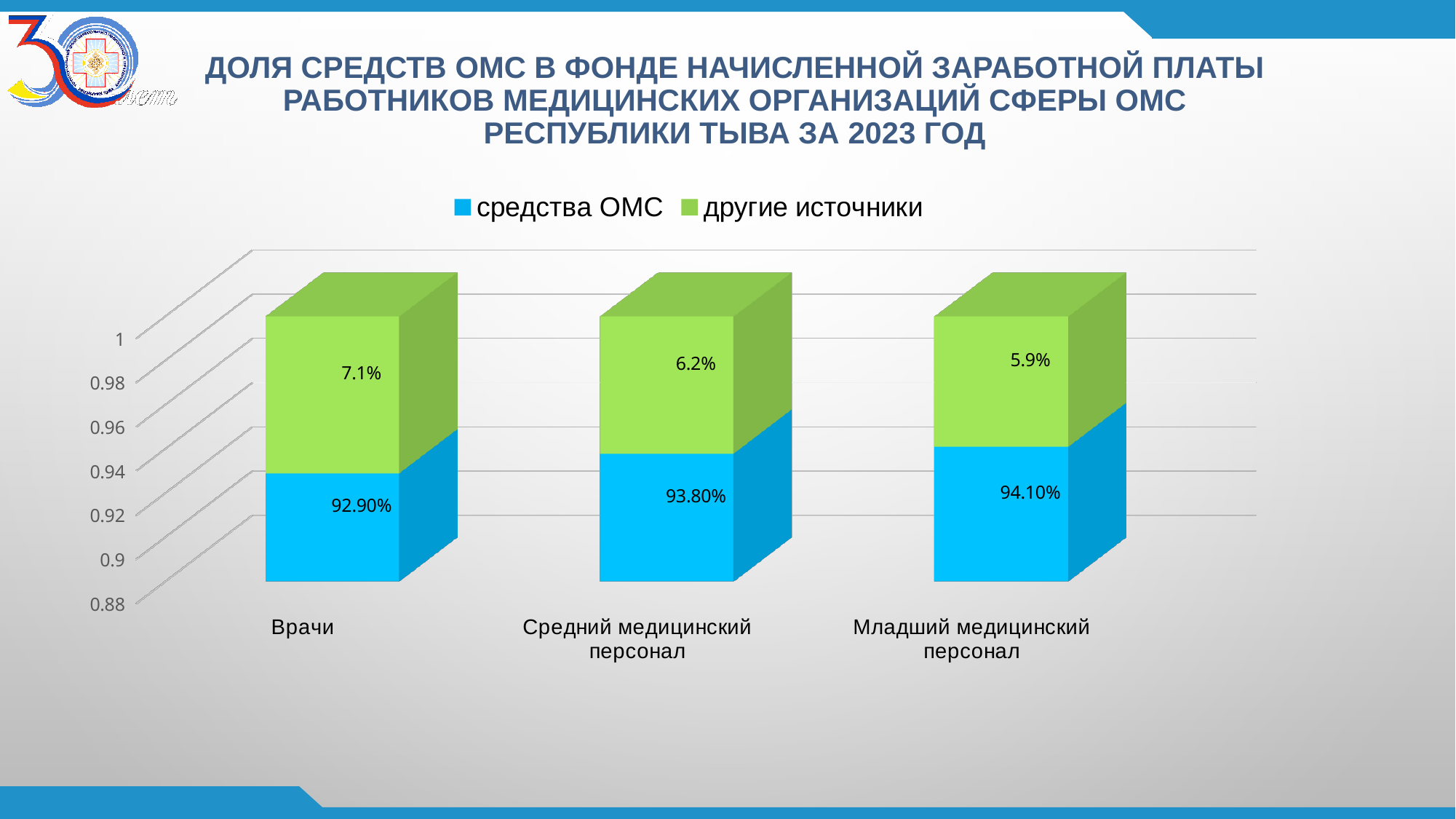
What kind of chart is shown on the slide? Stacked bar chart What is the value of средства ОМС for Врачи? 92.90% What is the difference between the средства ОМС values for Младший медицинский персонал and Врачи? 1.20% Which category has the lowest value for другие источники? Младший медицинский персонал Which category has the highest value for средства ОМС? Младший медицинский персонал What is the value of другие источники for Врачи? 7.1% Do the средства ОМС values rise or fall from Врачи to Младший медицинский персонал? Rise How many categories are shown on the x axis? 3 Which has the larger средства ОМС value: Врачи or Средний медицинский персонал? Средний медицинский персонал How many series does the legend list? 2 What is the value of другие источники for Средний медицинский персонал? 6.2% What is the value of средства ОМС for Младший медицинский персонал? 94.10%